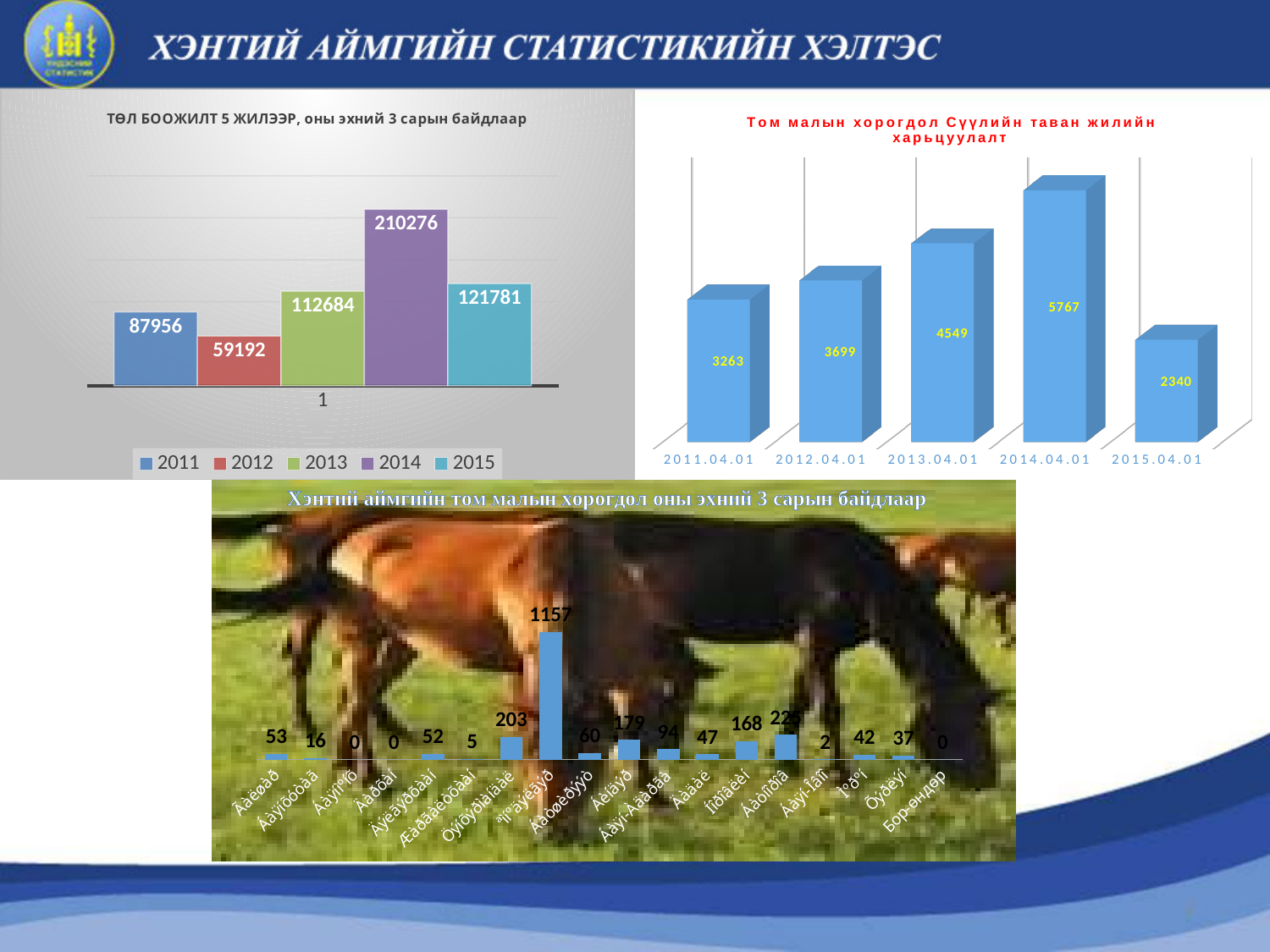
In the top-right chart 'Том малын хорогдол Сүүлийн таван жилийн харьцуулалт', what is the value for 2013.04.01? 4549 In the top-left chart 'ТӨЛ БООЖИЛТ 5 ЖИЛЭЭР', how many series does the legend list? 5 In the top-left chart 'ТӨЛ БООЖИЛТ 5 ЖИЛЭЭР', which is larger, the value for 2011 or the value for 2013? 2013 In the top-left chart 'ТӨЛ БООЖИЛТ 5 ЖИЛЭЭР', what is the difference between the 2014 and 2015 values? 88495 In the top-right chart 'Том малын хорогдол Сүүлийн таван жилийн харьцуулалт', which date has the highest value? 2014.04.01 What kind of chart is the bottom chart 'Хэнтий аймгийн том малын хорогдол оны эхний 3 сарын байдлаар'? bar chart In the top-right chart 'Том малын хорогдол Сүүлийн таван жилийн харьцуулалт', what is the difference between the 2014.04.01 and 2015.04.01 values? 3427 In the top-right chart 'Том малын хорогдол Сүүлийн таван жилийн харьцуулалт', do the values rise or fall from 2011.04.01 to 2014.04.01? rise In the top-left chart 'ТӨЛ БООЖИЛТ 5 ЖИЛЭЭР', what is the value for 2014? 210276 In the top-left chart 'ТӨЛ БООЖИЛТ 5 ЖИЛЭЭР', which year has the lowest value? 2012 In the top-right chart 'Том малын хорогдол Сүүлийн таван жилийн харьцуулалт', how many categories are shown on the x axis? 5 In the bottom chart 'Хэнтий аймгийн том малын хорогдол оны эхний 3 сарын байдлаар', what is the highest value shown? 1157